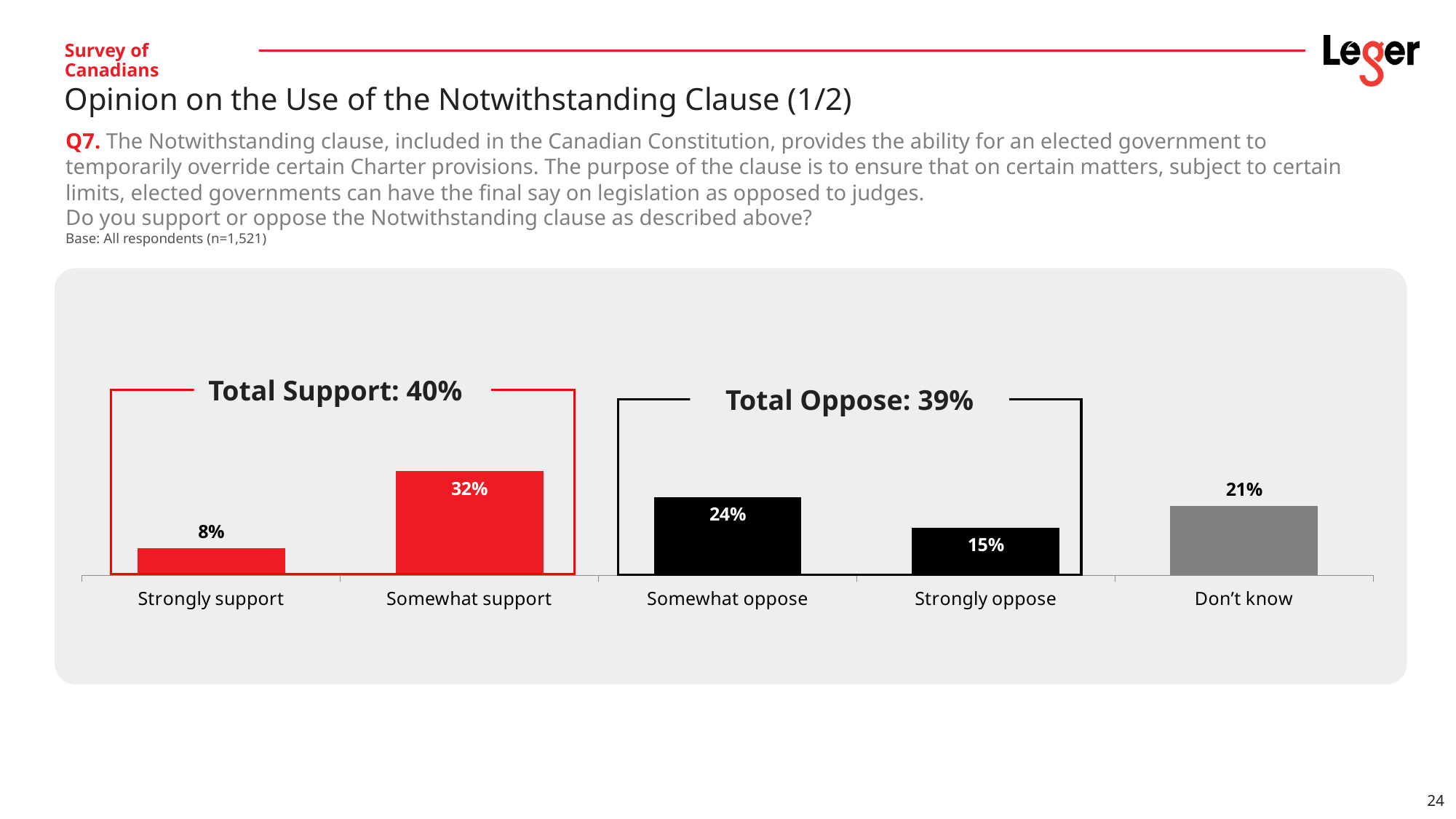
What colour are the bars for the oppose categories? Black What is the difference between 'Somewhat support' and 'Somewhat oppose'? 8% What kind of chart is shown on the slide? Bar chart What is the Total Support percentage shown on the chart? 40% Which is larger, 'Somewhat oppose' or 'Don't know'? Somewhat oppose What percentage of respondents answered 'Don't know'? 21% Which response category has the highest value? Somewhat support What is the value for 'Strongly oppose'? 15% How many response categories are shown on the chart? 5 Which response category has the lowest value? Strongly support What percentage of respondents strongly support the Notwithstanding clause? 8% What percentage of respondents somewhat support the Notwithstanding clause? 32%